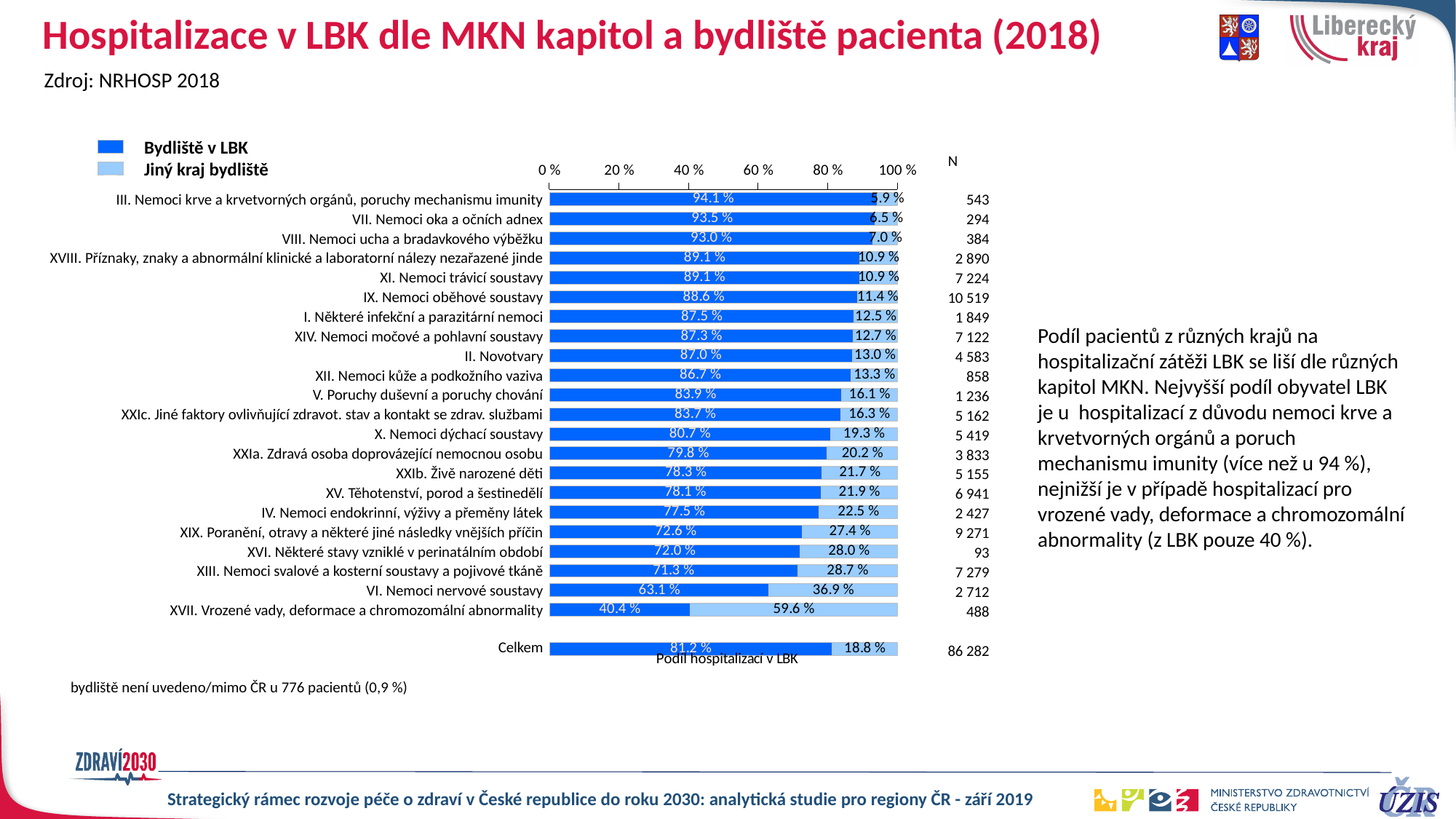
What is the Jiný kraj bydliště share for XVII. Vrozené vady, deformace a chromozomální abnormality? 59.6 % Which category has the lowest Bydliště v LBK share? XVII. Vrozené vady, deformace a chromozomální abnormality What is the Bydliště v LBK share for the Celkem row? 81.2 % What is the N value shown for IX. Nemoci oběhové soustavy? 10 519 What is the difference in Bydliště v LBK share between III. Nemoci krve a krvetvorných orgánů, poruchy mechanismu imunity and XVII. Vrozené vady, deformace a chromozomální abnormality? 53.7 percentage points What are the two series named in the legend? Bydliště v LBK and Jiný kraj bydliště How many series does the legend list? 2 What kind of chart is shown on the slide? Stacked horizontal bar chart What is the total of the stacked bar for VI. Nemoci nervové soustavy (Bydliště v LBK plus Jiný kraj bydliště)? 100 % What is the Bydliště v LBK share for III. Nemoci krve a krvetvorných orgánů, poruchy mechanismu imunity? 94.1 % Which category has the highest Bydliště v LBK share? III. Nemoci krve a krvetvorných orgánů, poruchy mechanismu imunity Which has a larger Bydliště v LBK share: X. Nemoci dýchací soustavy or XIII. Nemoci svalové a kosterní soustavy a pojivové tkáně? X. Nemoci dýchací soustavy